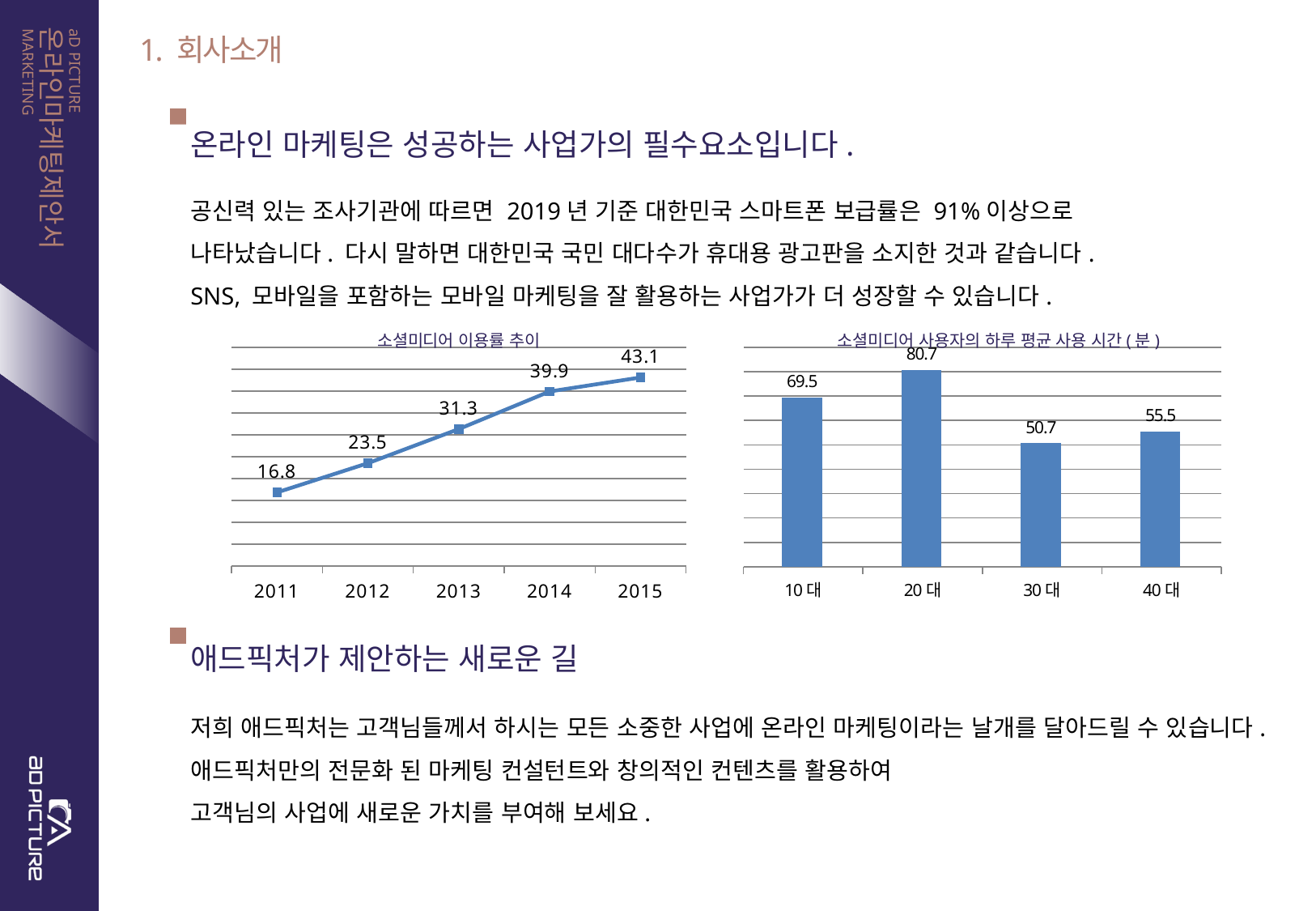
In the left chart (소셜미디어 이용률 추이), what is the value for 2011? 16.8 In the left chart (소셜미디어 이용률 추이), what is the difference between the 2015 and 2011 values? 26.3 What kind of chart is the left chart (소셜미디어 이용률 추이)? line chart In the left chart (소셜미디어 이용률 추이), how many years are plotted? 5 In the right chart (소셜미디어 사용자의 하루 평균 사용 시간), what is the value for 20대? 80.7 In the left chart (소셜미디어 이용률 추이), which year has the highest value? 2015 In the left chart (소셜미디어 이용률 추이), what is the value for 2013? 31.3 In the left chart (소셜미디어 이용률 추이), do the values rise or fall from 2011 to 2015? rise What kind of chart is the right chart (소셜미디어 사용자의 하루 평균 사용 시간)? bar chart In the right chart (소셜미디어 사용자의 하루 평균 사용 시간), which is larger, the value for 10대 or 40대? 10대 In the right chart (소셜미디어 사용자의 하루 평균 사용 시간), which age group has the lowest value? 30대 In the right chart (소셜미디어 사용자의 하루 평균 사용 시간), what is the difference between the values for 20대 and 30대? 30